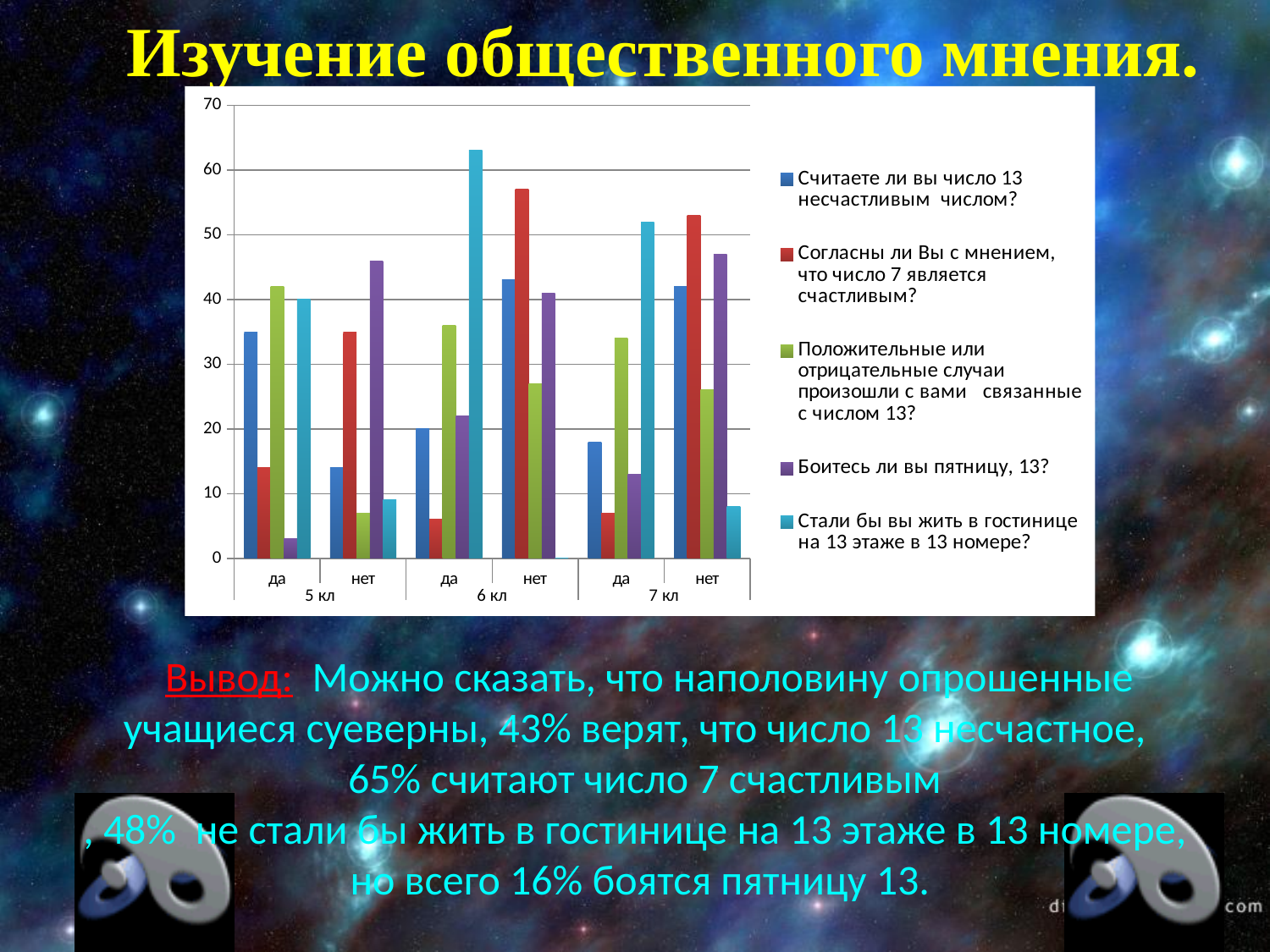
Is the value for 'Боитесь ли вы пятницу, 13?' in the 5 кл да group greater or less than 10? less What colour is used for the series 'Боитесь ли вы пятницу, 13?'? purple Is the value for 'Согласны ли Вы с мнением, что число 7 является счастливым?' in the 5 кл да group greater or less than 20? less How many series does the legend list? 5 In the 5 кл нет group, which is larger: the bar for 'Боитесь ли вы пятницу, 13?' or the bar for 'Положительные или отрицательные случаи произошли с вами связанные с числом 13?'? Боитесь ли вы пятницу, 13? Is the value for 'Согласны ли Вы с мнением, что число 7 является счастливым?' in the 6 кл нет group greater or less than 50? greater In the 6 кл да group, which is larger: the bar for 'Считаете ли вы число 13 несчастливым числом?' or the bar for 'Стали бы вы жить в гостинице на 13 этаже в 13 номере?'? Стали бы вы жить в гостинице на 13 этаже в 13 номере? Which class and answer has the tallest bar in the chart? 6 кл, да (Стали бы вы жить в гостинице на 13 этаже в 13 номере?) What kind of chart is shown on the slide? bar chart How many да/нет category groups are plotted along the x axis? 6 Which series has the lowest bar in the 5 кл да group? Боитесь ли вы пятницу, 13?